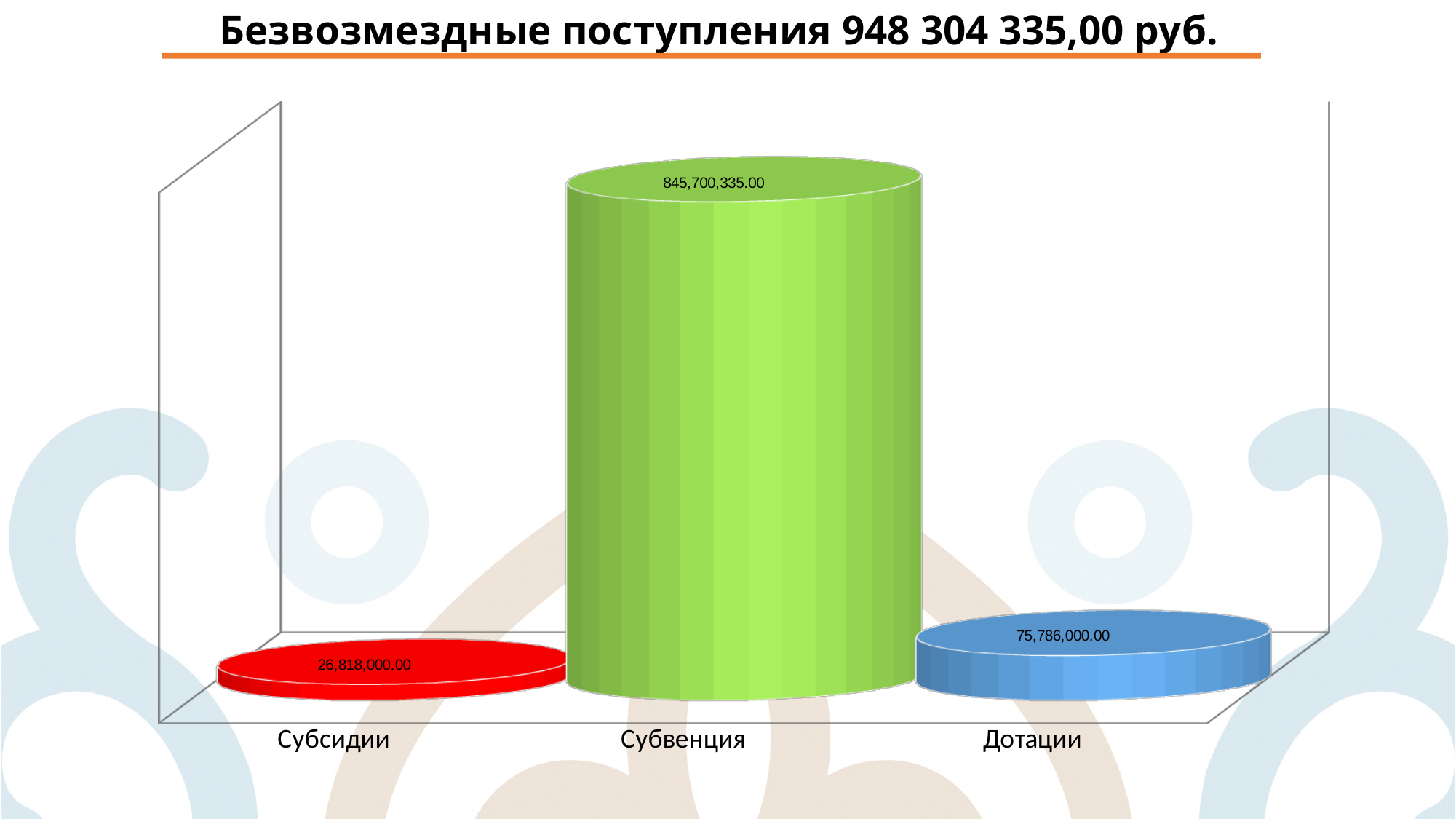
How many categories are shown in the chart? 3 What is the value for Субсидии? 26,818,000.00 What is the difference between the values for Субвенция and Дотации? 769,914,335.00 Which is larger, the value for Дотации or the value for Субсидии? Дотации Which category has the highest value? Субвенция What is the value for Дотации? 75,786,000.00 Which category has the lowest value? Субсидии What is the title of the slide? Безвозмездные поступления 948 304 335,00 руб. What kind of chart is shown on the slide? Bar chart What is the difference between the values for Дотации and Субсидии? 48,968,000.00 What colour is the bar for Субвенция? Green What is the value for Субвенция? 845,700,335.00